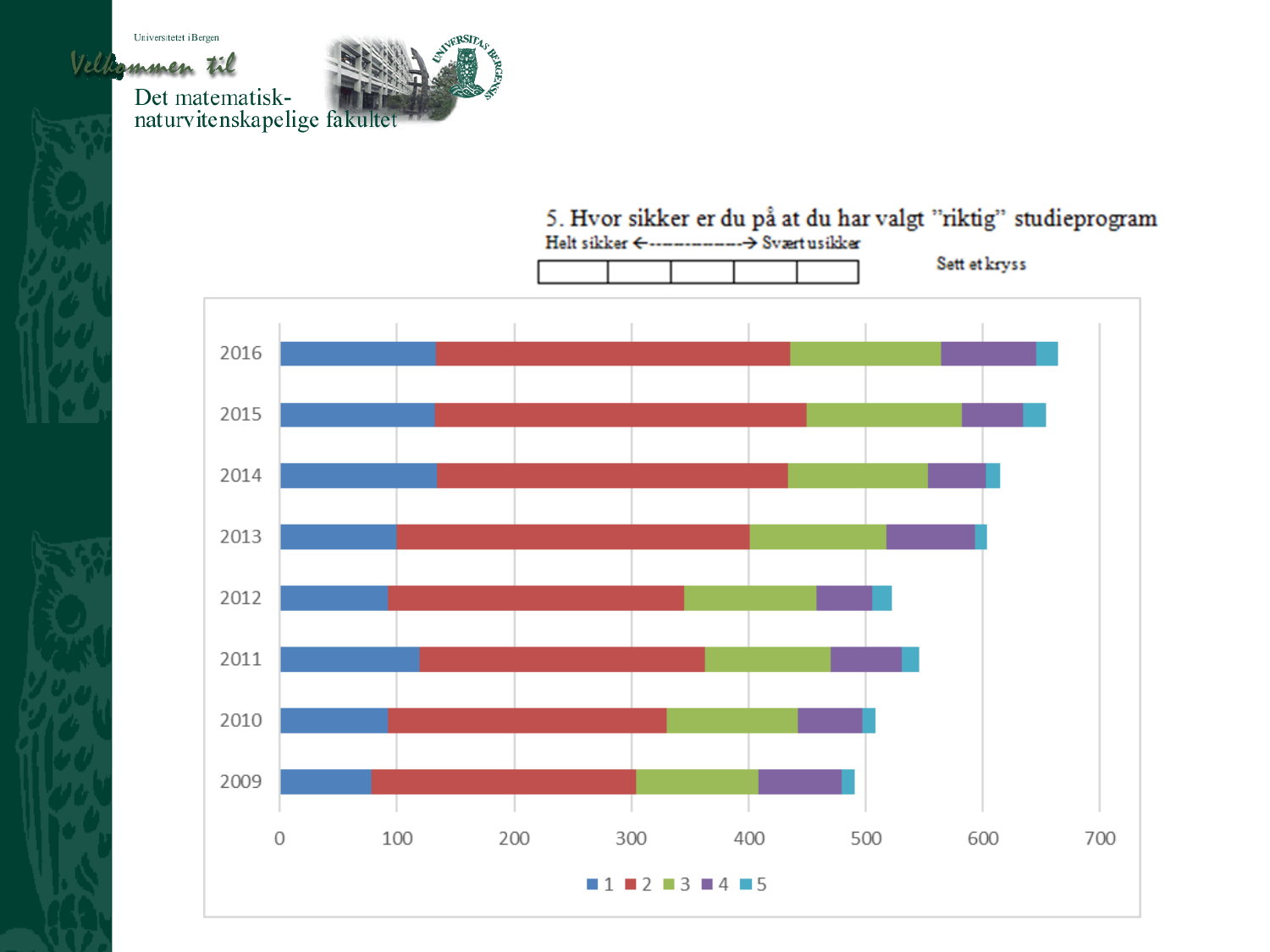
Is the value of series 1 for 2009 greater or less than 100? less Is the total bar length for 2016 greater or less than 600? greater What kind of chart is shown on the slide? stacked bar chart Is the total bar length for 2009 greater or less than 500? less How many series does the legend list? 5 How many years (categories) are shown on the chart? 8 Do the total bar lengths generally increase or decrease from 2009 to 2016? increase Which colour represents series 2 in the chart? red Which year has the longer total bar, 2016 or 2012? 2016 What are the legend entries of the chart? 1, 2, 3, 4, 5